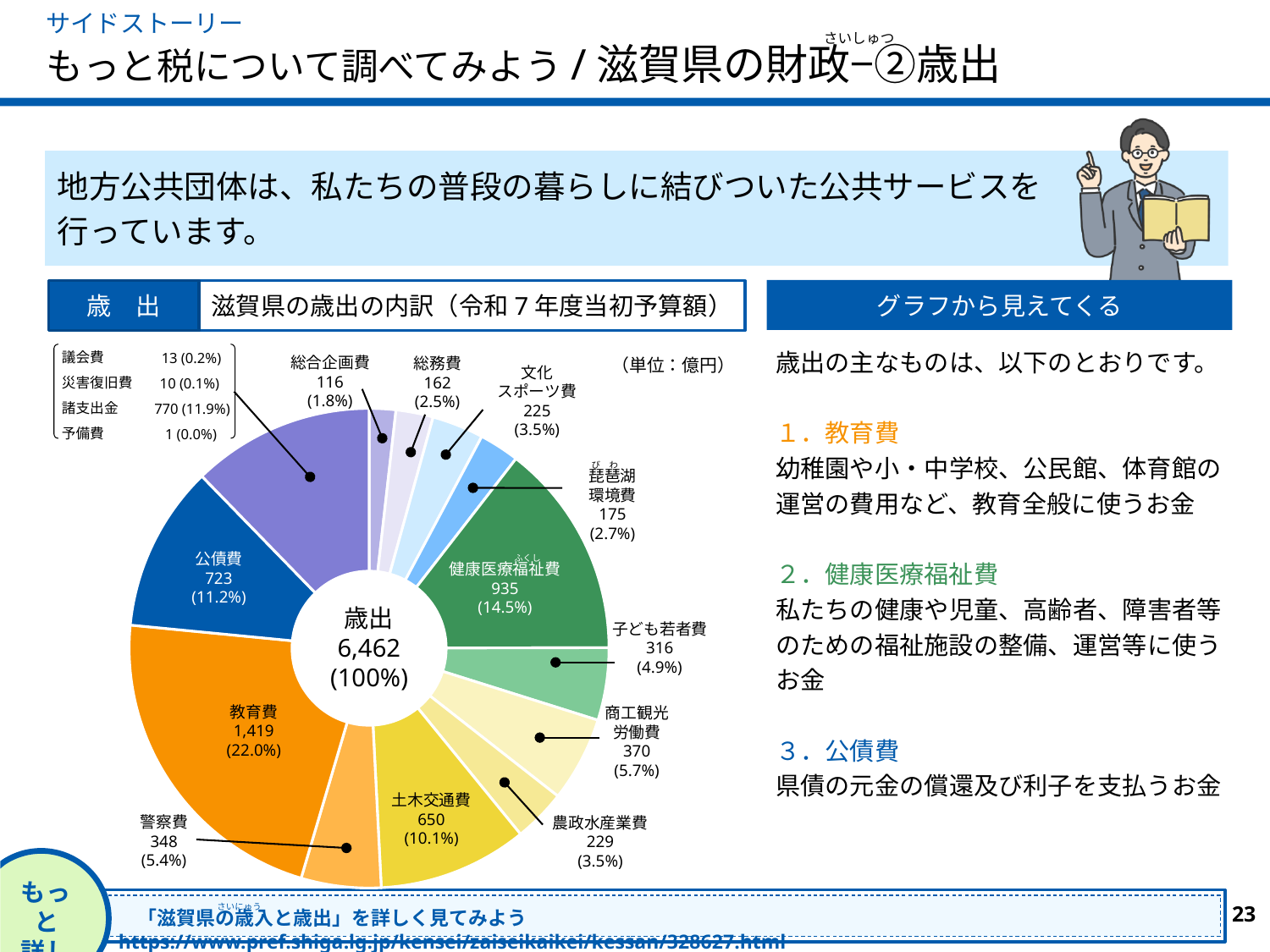
Which is larger in the pie chart, 土木交通費 or 商工観光労働費? 土木交通費 What kind of chart is used to show the breakdown of Shiga Prefecture's expenditure (滋賀県の歳出の内訳)? Pie chart How many expenditure categories are shown in the pie chart (including those listed in the bracket at the top left)? 16 What is the value for 公債費 in the pie chart, in 億円? 723 What is the value for 教育費 in the pie chart, in 億円? 1,419 What is the total expenditure (歳出) shown in the centre of the pie chart, in 億円? 6,462 What share of the expenditure does 警察費 account for in the pie chart? 5.4% Which category has the smallest value in the expenditure pie chart? 予備費 Which category has the largest share in the expenditure pie chart? 教育費 What unit is stated for the values in the pie chart? 億円 What share of the expenditure does 健康医療福祉費 account for in the pie chart? 14.5% What is the difference between 教育費 (1,419) and 健康医療福祉費 (935) in the pie chart, in 億円? 484